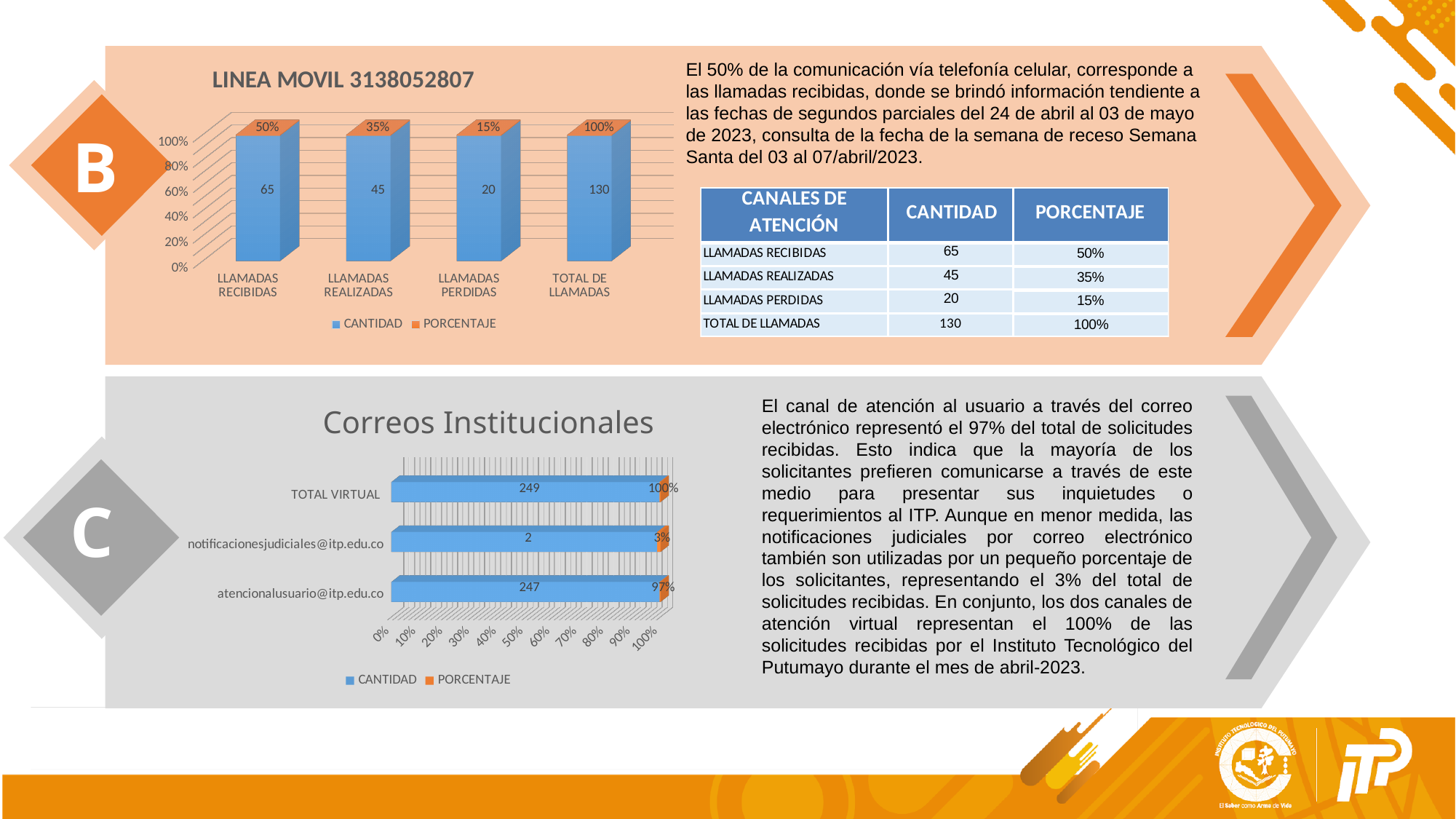
In the 'Correos Institucionales' chart, how many categories are plotted? 3 In the 'Correos Institucionales' chart, what is the CANTIDAD value for atencionalusuario@itp.edu.co? 247 In the 'LINEA MOVIL 3138052807' chart, how many series does the legend list? 2 In the 'Correos Institucionales' chart, which has the larger CANTIDAD value: atencionalusuario@itp.edu.co or notificacionesjudiciales@itp.edu.co? atencionalusuario@itp.edu.co What kind of chart is the 'LINEA MOVIL 3138052807' chart? Bar chart In the 'LINEA MOVIL 3138052807' chart, what is the CANTIDAD value for LLAMADAS RECIBIDAS? 65 In the 'LINEA MOVIL 3138052807' chart, what PORCENTAJE is shown for LLAMADAS PERDIDAS? 15% In the 'LINEA MOVIL 3138052807' chart, which category has the lowest CANTIDAD value? LLAMADAS PERDIDAS In the 'Correos Institucionales' chart, what is the difference between the CANTIDAD values for TOTAL VIRTUAL and atencionalusuario@itp.edu.co? 2 In the 'LINEA MOVIL 3138052807' chart, what is the difference between the CANTIDAD values for LLAMADAS RECIBIDAS and LLAMADAS REALIZADAS? 20 In the 'LINEA MOVIL 3138052807' chart, how many categories are shown on the x axis? 4 In the 'Correos Institucionales' chart, what PORCENTAJE is shown for notificacionesjudiciales@itp.edu.co? 3%